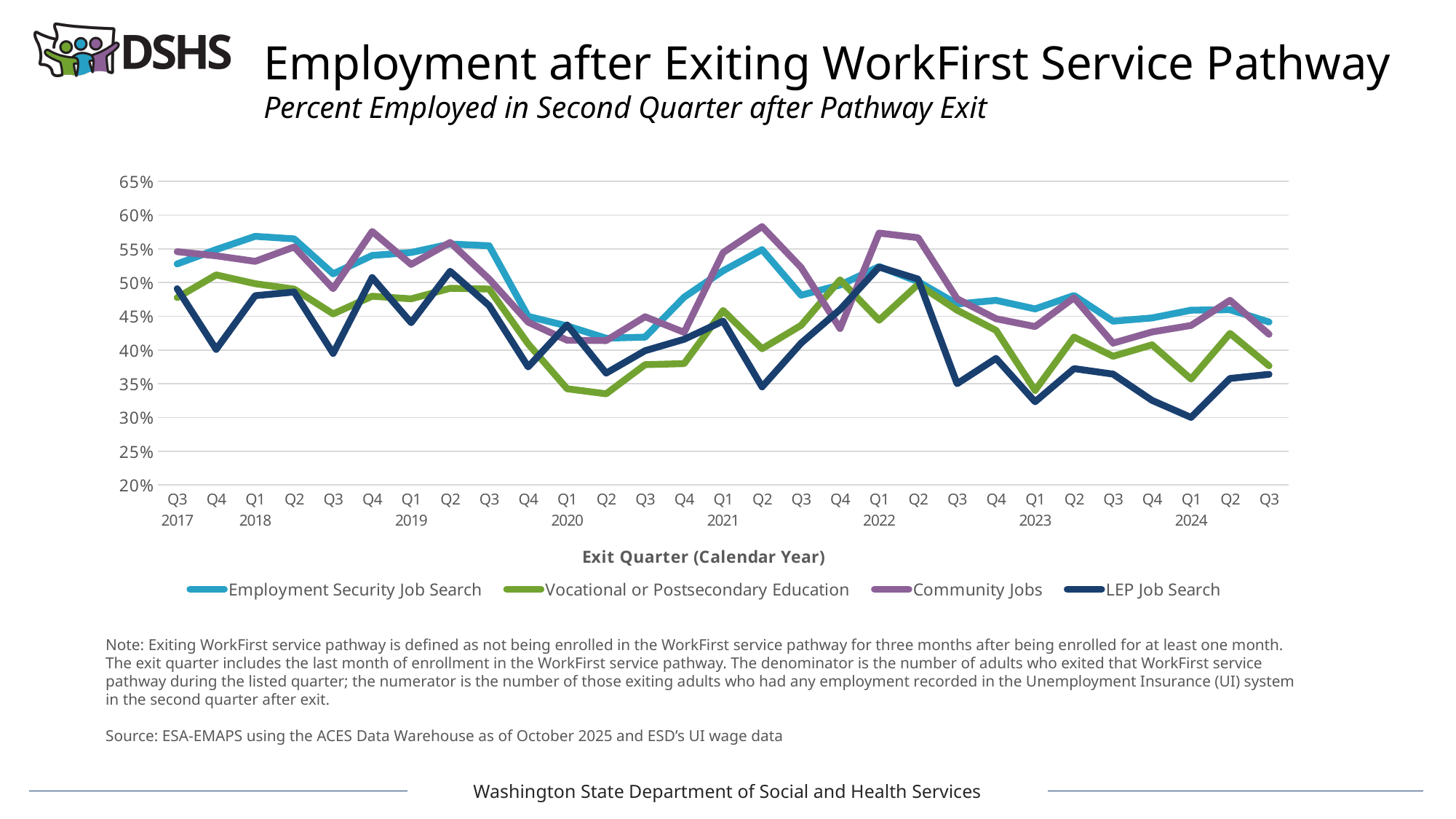
In Q2 2020, which is larger: Community Jobs or Vocational or Postsecondary Education? Community Jobs Is the value for LEP Job Search in Q1 2024 greater or less than 35%? less In Q1 2024, which is larger: Employment Security Job Search or LEP Job Search? Employment Security Job Search Is the value for Vocational or Postsecondary Education in Q2 2020 greater or less than 35%? less Is the value for LEP Job Search in Q2 2021 greater or less than 40%? less How many exit quarters are plotted along the x axis? 29 Does the LEP Job Search line rise or fall from Q1 2022 to Q1 2024? Fall In which exit quarter does the LEP Job Search line reach its lowest value? Q1 2024 How many series does the legend list? 4 What is the label of the x axis? Exit Quarter (Calendar Year) What kind of chart is shown on the slide? Line chart